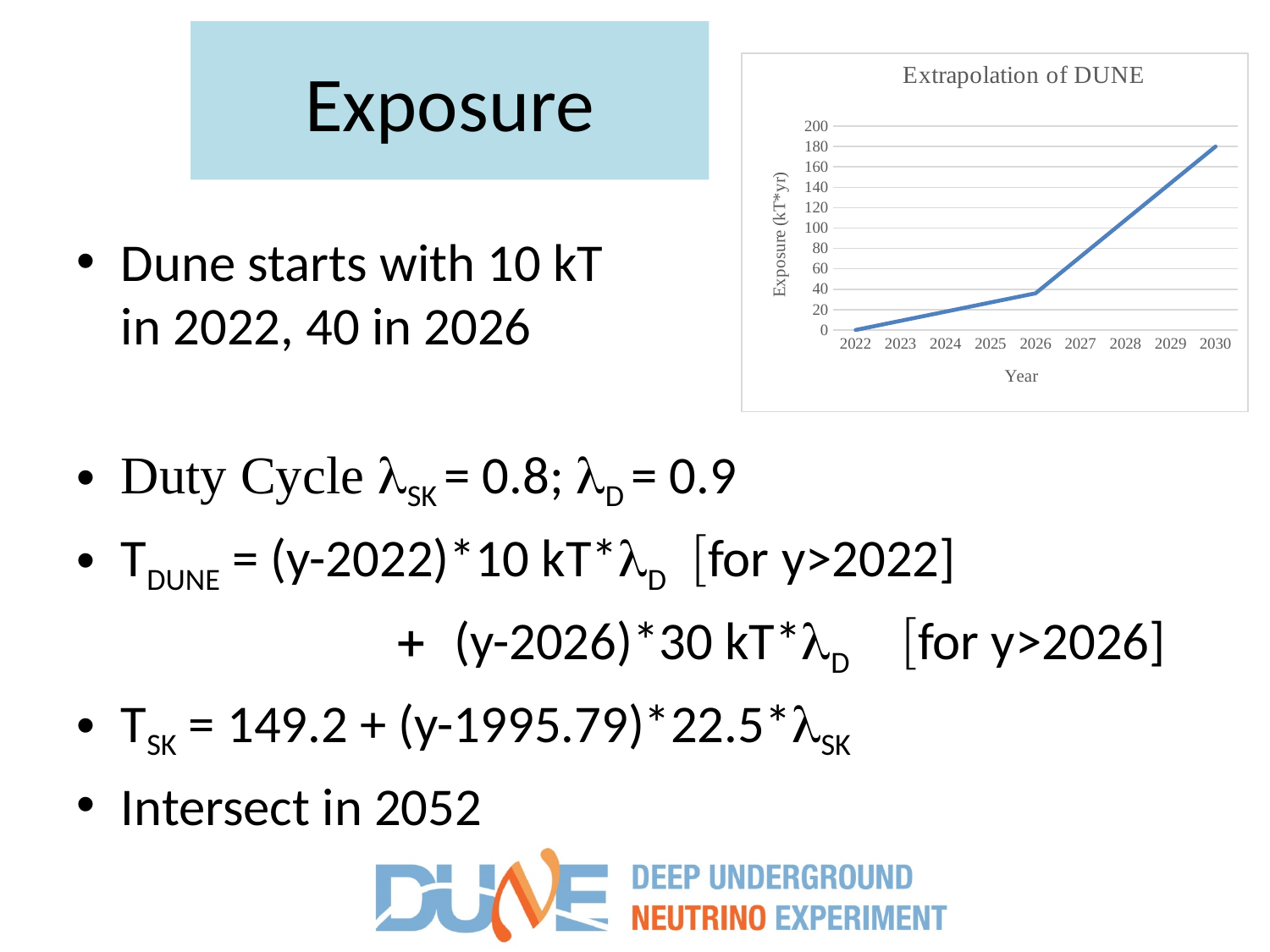
What kind of chart is shown on the slide? line chart What is the exposure value for 2030 in the chart? 180 What is the label of the y axis of the chart? Exposure (kT*yr) In which year is the exposure lowest in the chart? 2022 What is the exposure value for 2022 in the chart? 0 What is the title of the chart? Extrapolation of DUNE Does the exposure rise or fall from 2022 to 2030 in the chart? rise In which year is the exposure highest in the chart? 2030 Is the exposure value for 2026 greater or less than 60? less Is the exposure value for 2028 greater or less than 80? greater Which year has the larger exposure, 2026 or 2030? 2030 How many years are marked along the x axis of the chart? 9